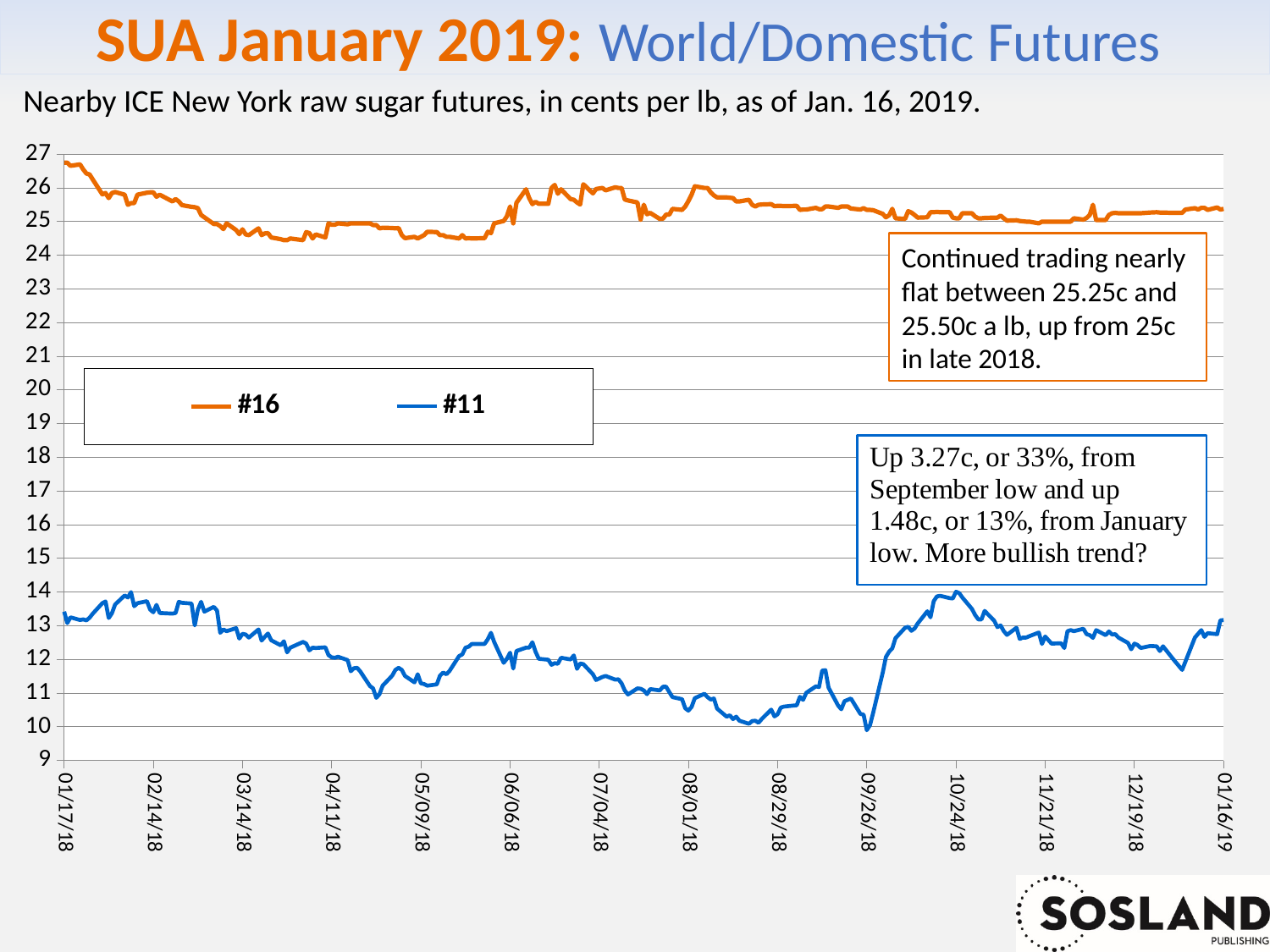
What kind of chart is shown on the slide? line chart How many date labels are shown on the x axis? 14 What colour is the line for the #11 series? blue Is the value of the #11 series at 10/24/18 greater or less than 13? greater Is the value of the #11 series at 09/26/18 greater or less than 11? less Is the value of the #16 series at 01/17/18 greater or less than 26? greater Which series has the higher values throughout the chart, #16 or #11? #16 What is the highest value shown on the y axis? 27 How many series does the legend list? 2 Does the #11 series rise or fall between 01/17/18 and 09/26/18? fall